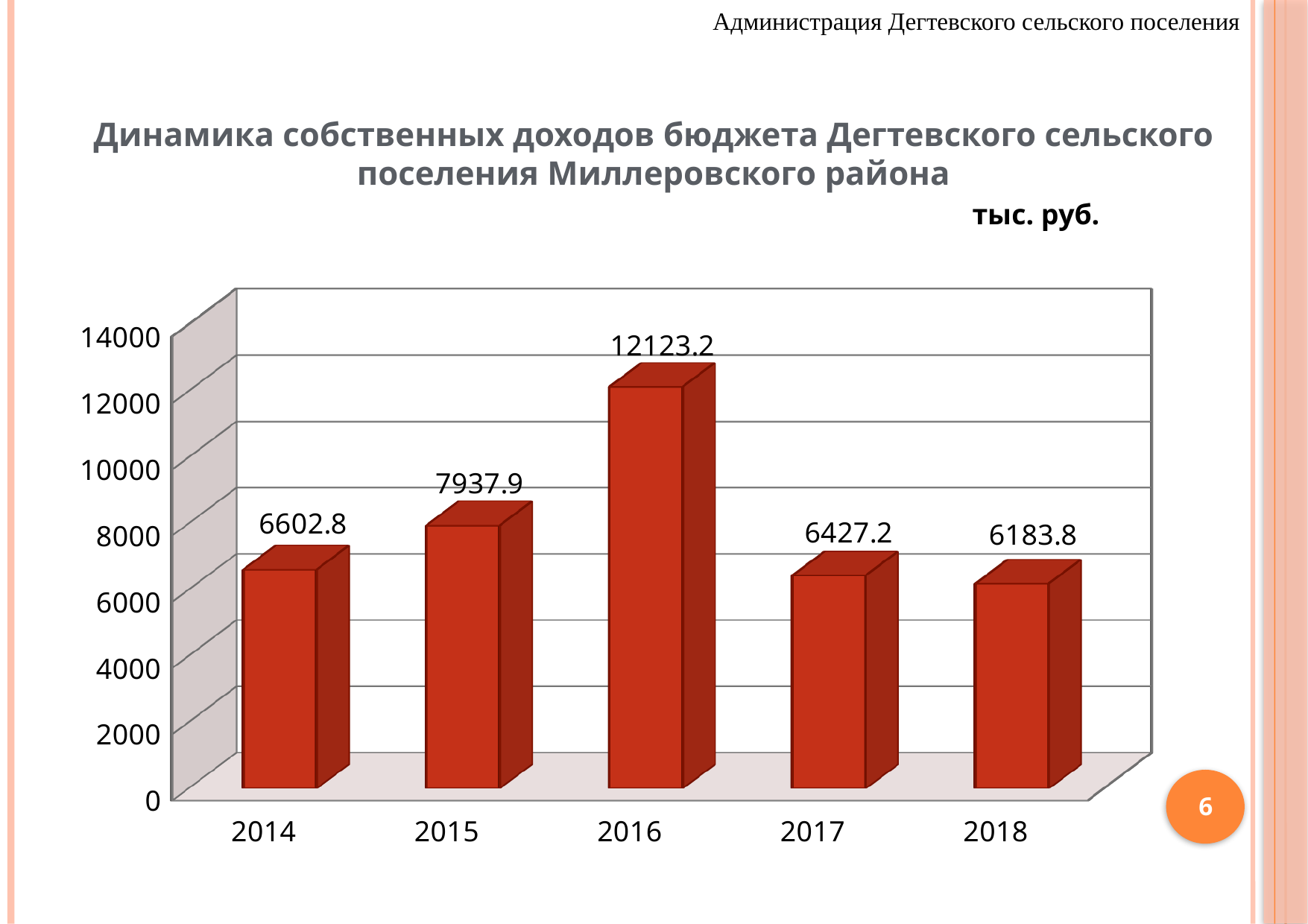
Which year has the highest value? 2016 What is the value for 2018? 6183.8 What is the difference between the values for 2014 and 2018? 419 Which is larger, the value for 2015 or the value for 2017? 2015 How many years are shown on the x axis? 5 What is the difference between the values for 2016 and 2015? 4185.3 What unit is indicated above the chart? тыс. руб. What is the value for 2016? 12123.2 What is the value for 2014? 6602.8 Is the value for 2016 greater or less than 10000? greater Which year has the lowest value? 2018 What kind of chart is shown on the slide? bar chart